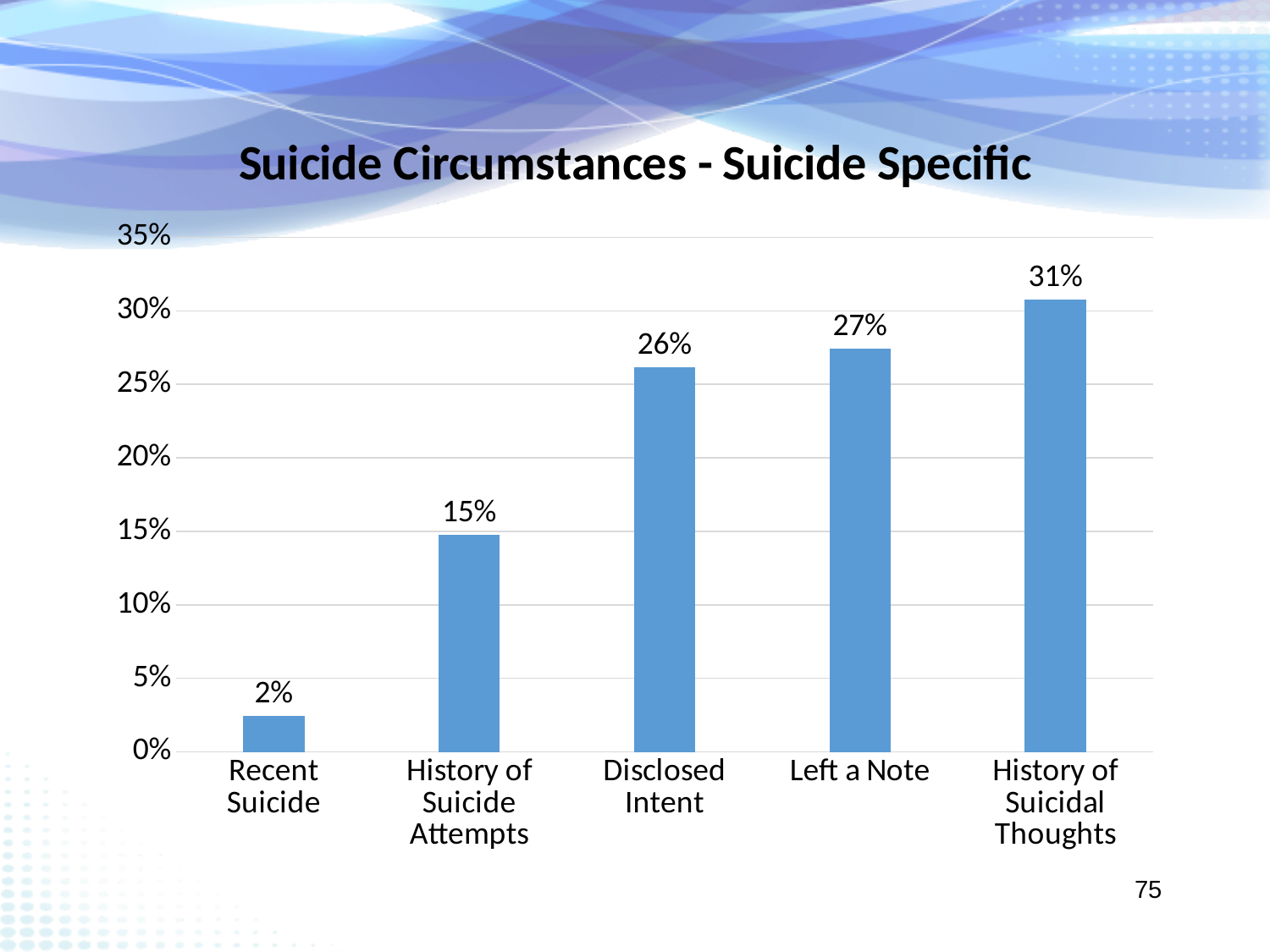
What is the difference between History of Suicidal Thoughts and History of Suicide Attempts? 16% What is the value for History of Suicide Attempts? 15% What is the value for Left a Note? 27% What is the value for Recent Suicide? 2% What is the title of the chart? Suicide Circumstances - Suicide Specific Which is larger, the value for Disclosed Intent or the value for History of Suicide Attempts? Disclosed Intent How many categories are shown in the chart? 5 What is the value for History of Suicidal Thoughts? 31% Which category has the lowest value? Recent Suicide What is the value for Disclosed Intent? 26% Which category has the highest value? History of Suicidal Thoughts What kind of chart is shown on the slide? Bar chart